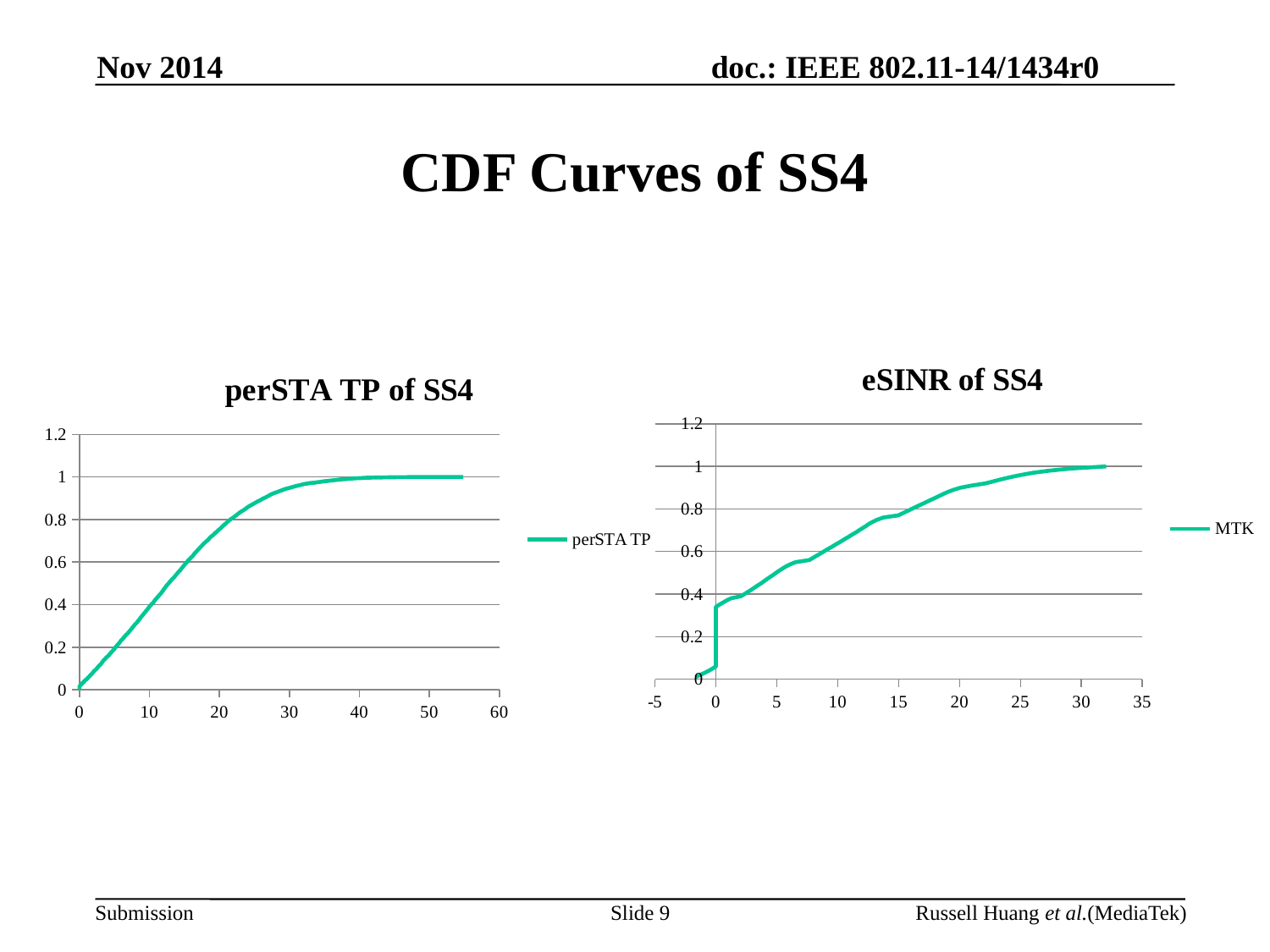
In the 'eSINR of SS4' chart, is the value at x = 10 greater or less than 0.4? greater In the 'eSINR of SS4' chart, do the values rise or fall as x increases? rise What is the name of the series shown in the legend of the 'eSINR of SS4' chart? MTK What is the name of the series shown in the legend of the 'perSTA TP of SS4' chart? perSTA TP In the 'eSINR of SS4' chart, is the value at x = 20 greater or less than 0.8? greater What kind of chart is the 'perSTA TP of SS4' chart? line chart How many series does the legend of the 'eSINR of SS4' chart list? 1 In the 'perSTA TP of SS4' chart, is the value at x = 30 greater or less than 0.8? greater How many series does the legend of the 'perSTA TP of SS4' chart list? 1 In the 'perSTA TP of SS4' chart, do the values rise or fall as x increases? rise What kind of chart is the 'eSINR of SS4' chart? line chart